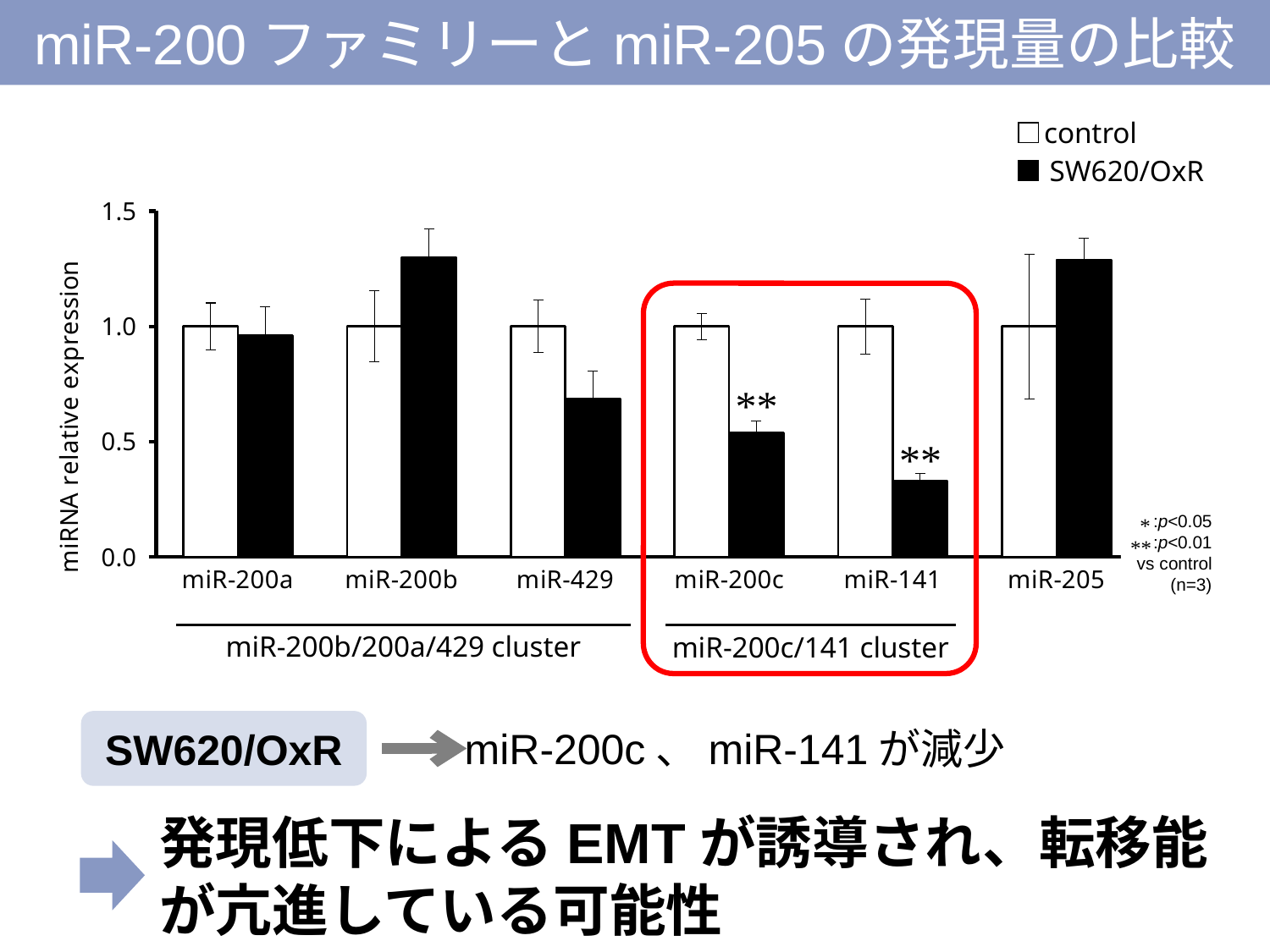
What is the control value for miR-200c? 1.0 How many miRNA categories are plotted on the x axis? 6 What kind of chart is shown on the slide? bar chart What is the label of the y axis? miRNA relative expression How many series does the legend list? 2 Which miRNA has the lowest SW620/OxR value? miR-141 Is the SW620/OxR value for miR-141 greater or less than 0.5? less Is the SW620/OxR value for miR-200b greater or less than 1.0? greater Is the SW620/OxR value for miR-205 greater or less than 1.0? greater Which is larger, the SW620/OxR value for miR-200b or for miR-429? miR-200b Which is larger, the SW620/OxR value for miR-200c or for miR-141? miR-200c